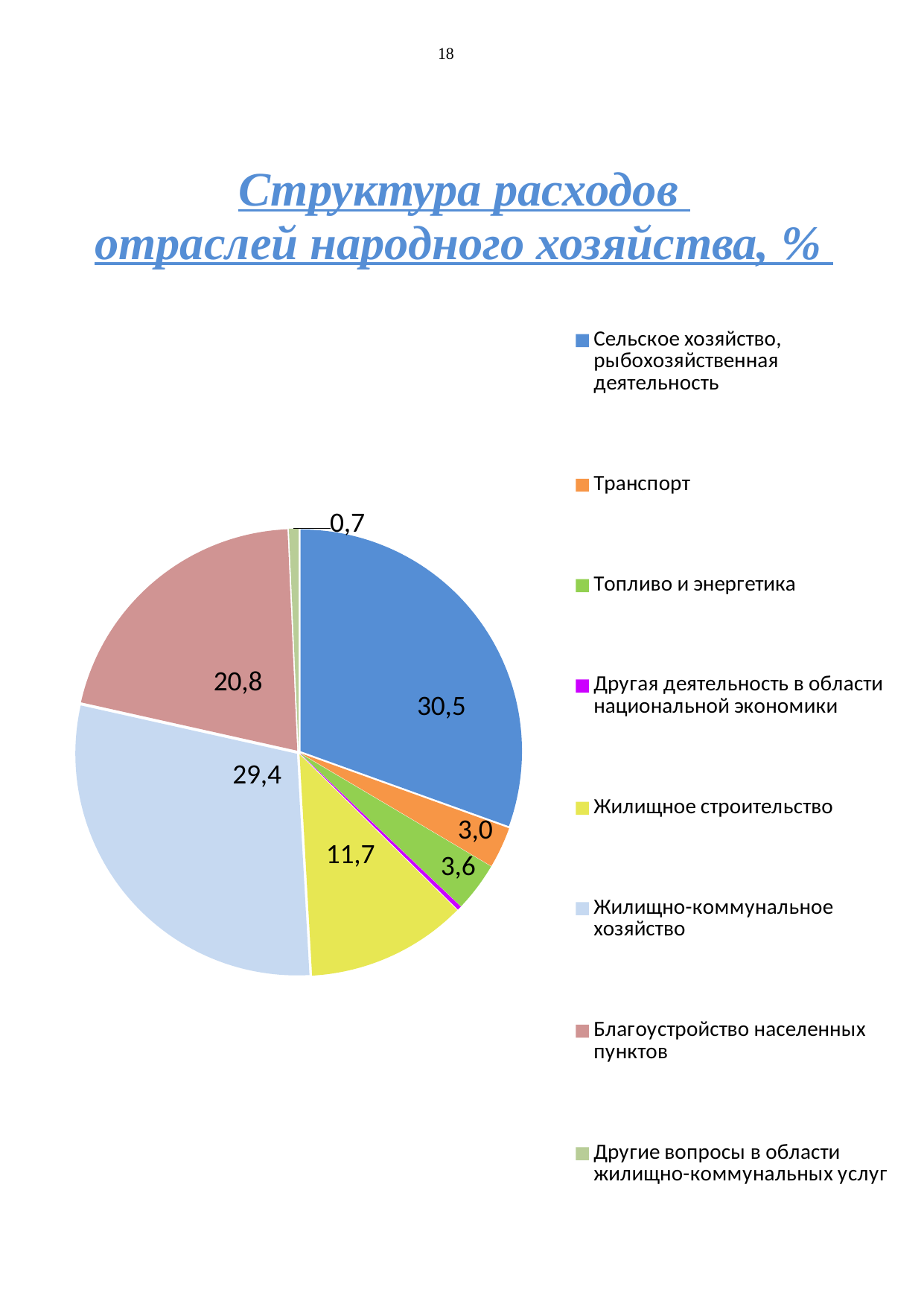
What is the value for Транспорт? 3,0 Which is larger, Транспорт or Топливо и энергетика? Топливо и энергетика What is the title of the chart? Структура расходов отраслей народного хозяйства, % What is the value for Жилищно-коммунальное хозяйство? 29,4 What is the value for Жилищное строительство? 11,7 What is the difference between the values for Сельское хозяйство, рыбохозяйственная деятельность and Жилищно-коммунальное хозяйство? 1,1 What is the value for Благоустройство населенных пунктов? 20,8 Which category has the largest share of the pie? Сельское хозяйство, рыбохозяйственная деятельность What is the value for Другие вопросы в области жилищно-коммунальных услуг? 0,7 How many categories does the legend list? 8 What is the value for Сельское хозяйство, рыбохозяйственная деятельность? 30,5 What type of chart is shown on the slide? Pie chart